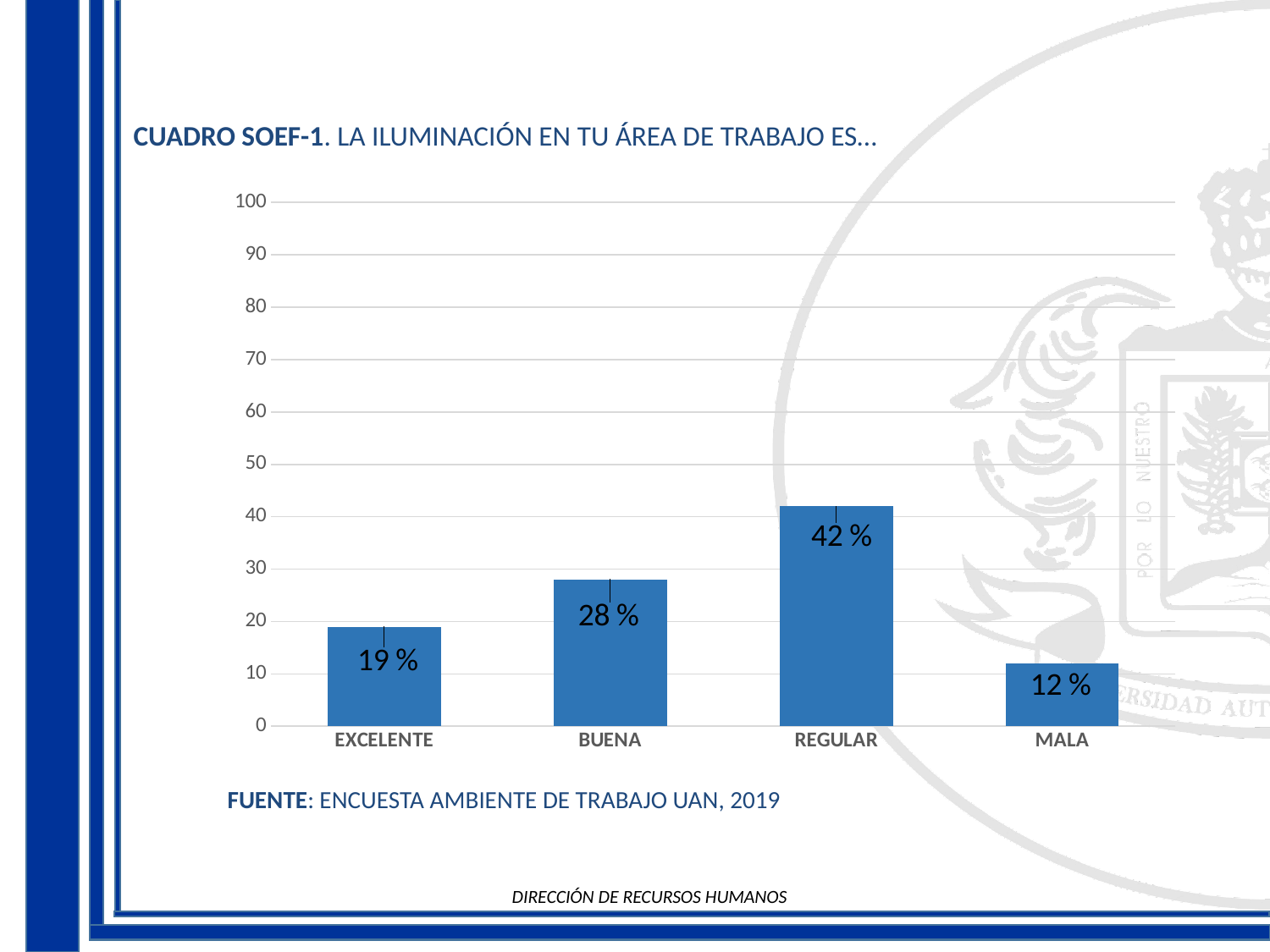
What kind of chart is shown on the slide? bar chart What is the value for MALA? 12 % What is the value for REGULAR? 42 % What is the title of the chart? CUADRO SOEF-1. LA ILUMINACIÓN EN TU ÁREA DE TRABAJO ES… What is the difference between the values for REGULAR and BUENA? 14 % Which is larger, the value for BUENA or the value for EXCELENTE? BUENA What is the value for EXCELENTE? 19 % What is the source cited below the chart? ENCUESTA AMBIENTE DE TRABAJO UAN, 2019 Which category has the highest value? REGULAR Is the value for BUENA greater or less than 30? less Which category has the lowest value? MALA How many categories are shown on the x axis? 4